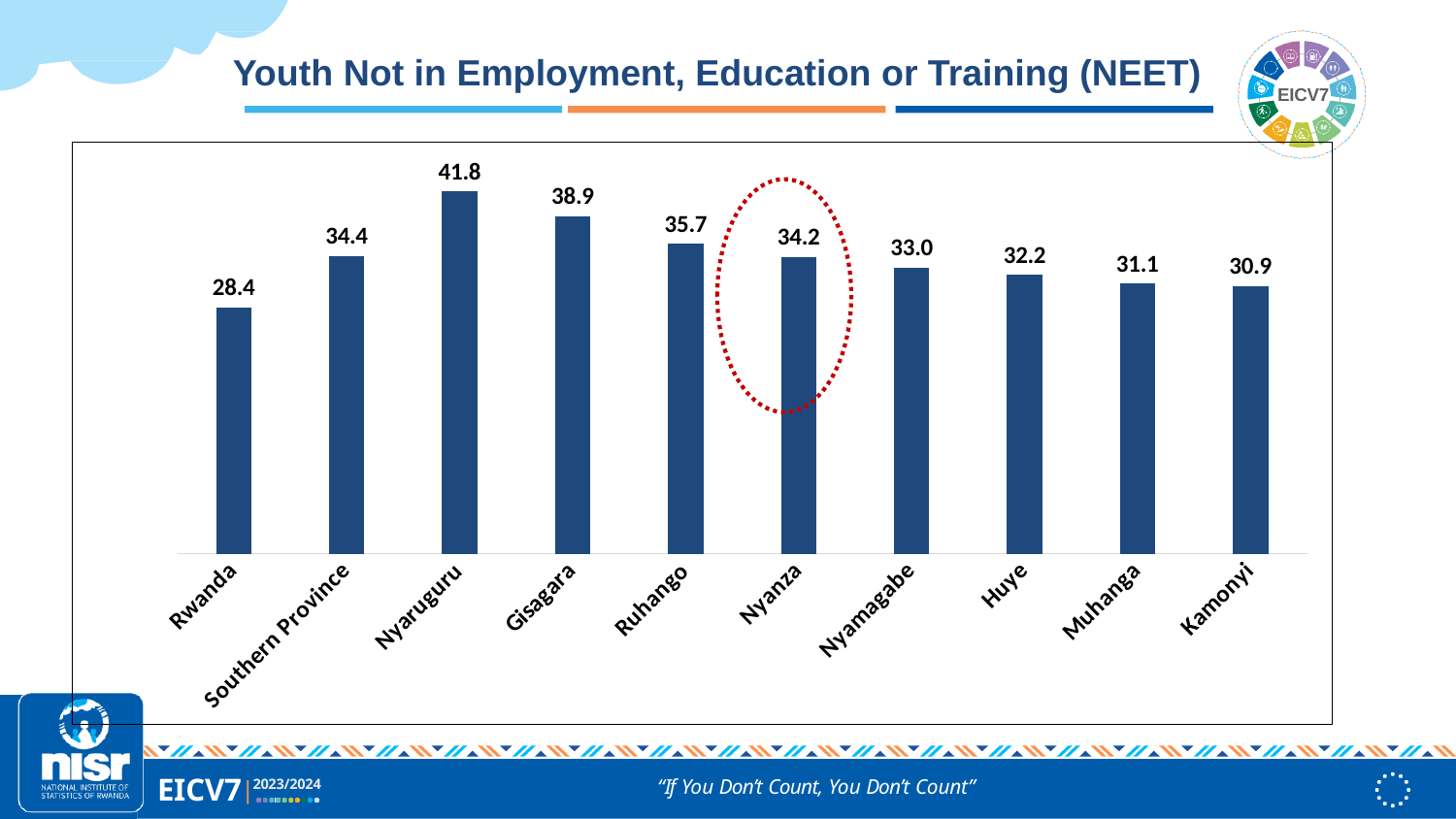
What is the NEET value for Rwanda? 28.4 Which category has the lowest NEET value? Rwanda What is the difference between the NEET values for Nyaruguru and Rwanda? 13.4 What is the NEET value for Nyaruguru? 41.8 What is the difference between the NEET values for Gisagara and Kamonyi? 8.0 What is the NEET value for Nyanza? 34.2 Which has a higher NEET value, Ruhango or Huye? Ruhango How many categories are shown on the chart? 10 What is the NEET value for Southern Province? 34.4 Which category's bar is circled with a red dotted outline? Nyanza Which category has the highest NEET value? Nyaruguru What kind of chart is shown on the slide? Bar chart